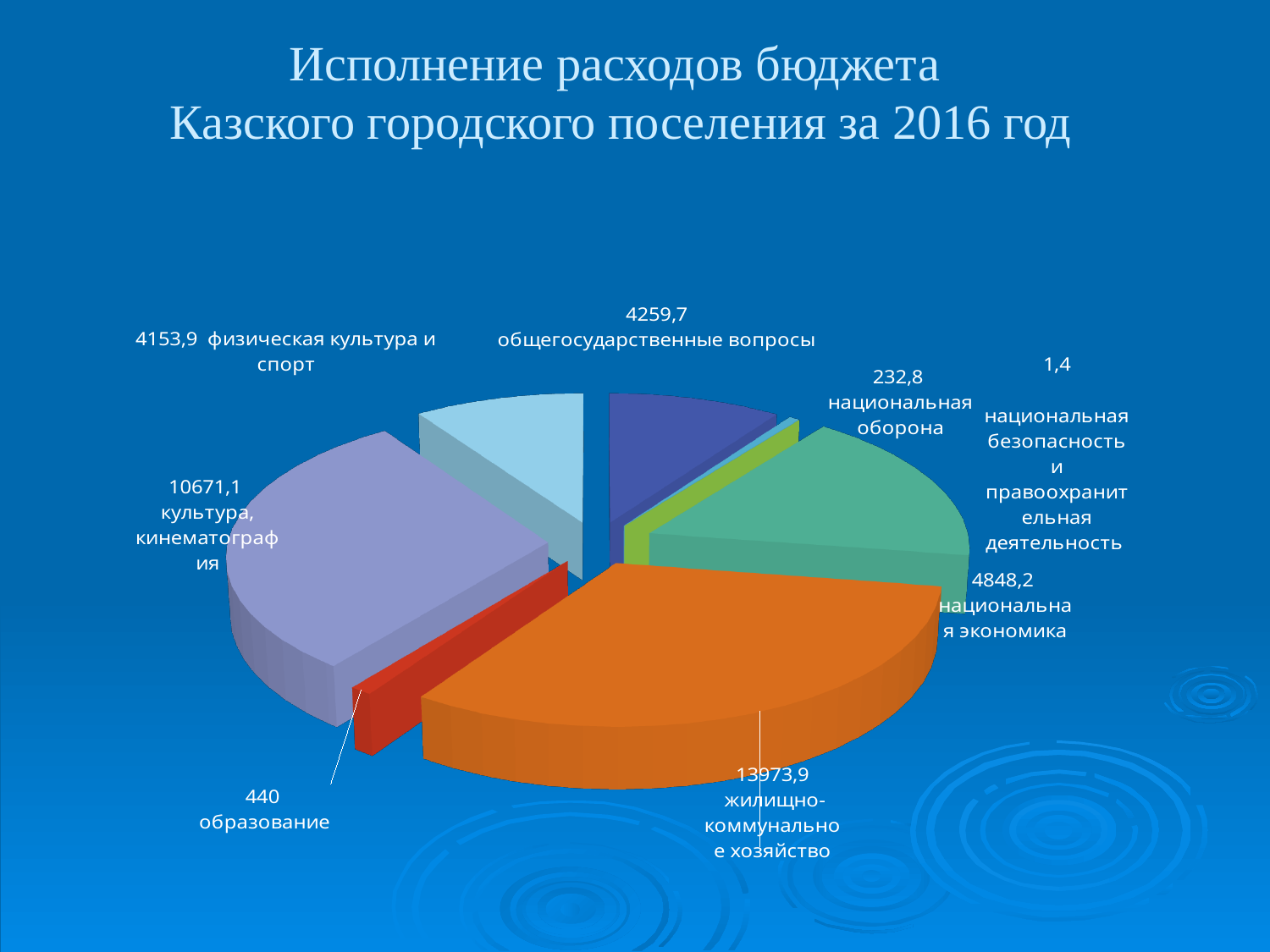
Which category has the smallest value? национальная безопасность и правоохранительная деятельность What is the value for культура, кинематография? 10671,1 What is the value for национальная оборона? 232,8 How many categories are shown in the pie chart? 8 Which category has the largest slice of the pie? жилищно-коммунальное хозяйство Which is larger: национальная экономика or общегосударственные вопросы? национальная экономика What is the value for национальная безопасность и правоохранительная деятельность? 1,4 What is the title of the slide? Исполнение расходов бюджета Казского городского поселения за 2016 год What is the value for образование? 440 What type of chart is shown on the slide? Pie chart What is the value for жилищно-коммунальное хозяйство? 13973,9 What is the difference between жилищно-коммунальное хозяйство and культура, кинематография? 3302,8